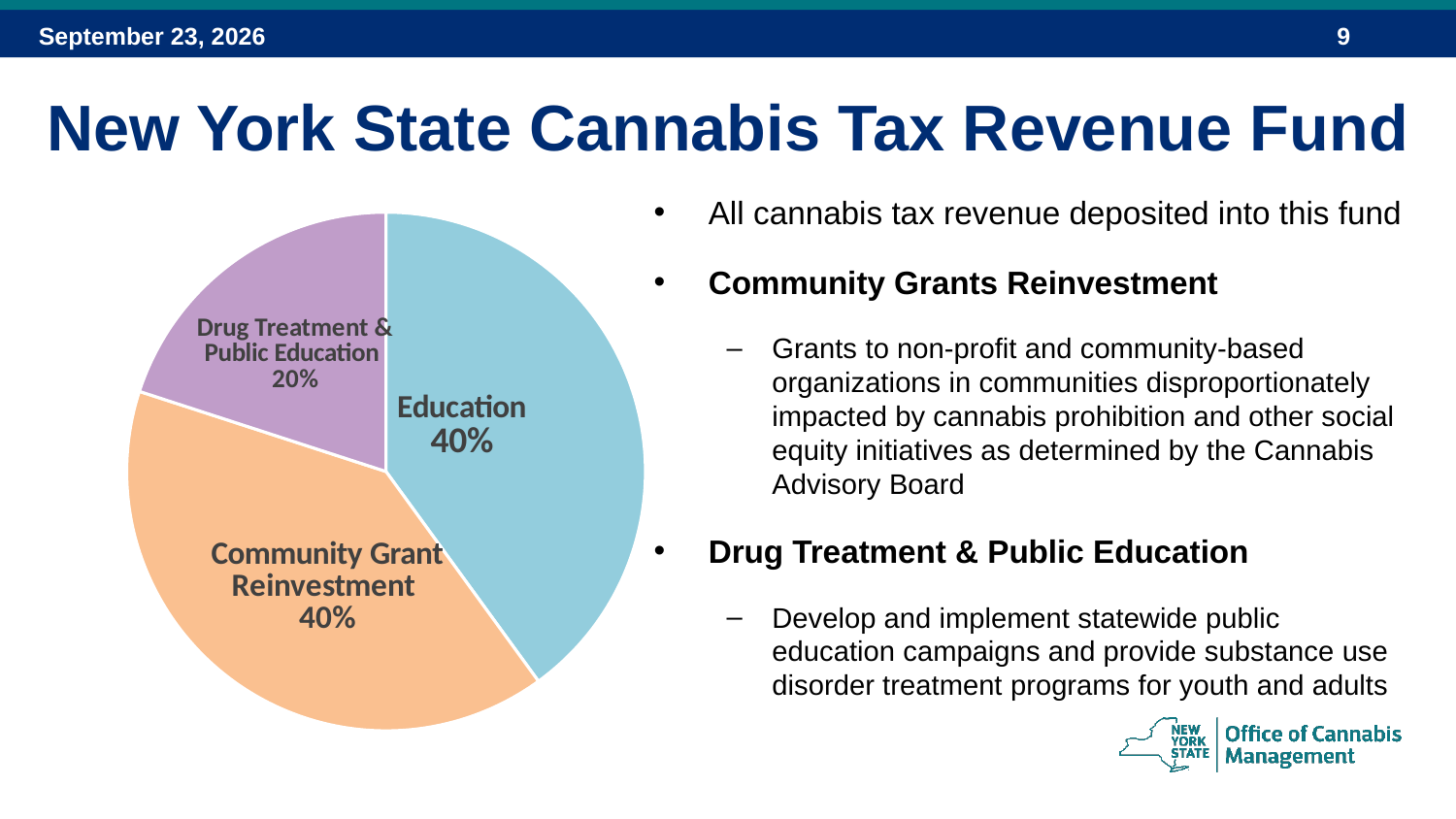
What is the combined share of Education and Community Grant Reinvestment? 80% Which slice of the pie chart is the smallest? Drug Treatment & Public Education What share of the fund goes to Education? 40% What share of the fund goes to Drug Treatment & Public Education? 20% How many slices does the pie chart have? 3 What is the difference between the Education share and the Drug Treatment & Public Education share? 20% What kind of chart is shown on the slide? pie chart What colour is the Community Grant Reinvestment slice of the pie chart? orange Is the share for Drug Treatment & Public Education greater or less than 25%? less What share of the fund goes to Community Grant Reinvestment? 40% What colour is the Education slice of the pie chart? light blue Which is larger, the Community Grant Reinvestment slice or the Drug Treatment & Public Education slice? Community Grant Reinvestment